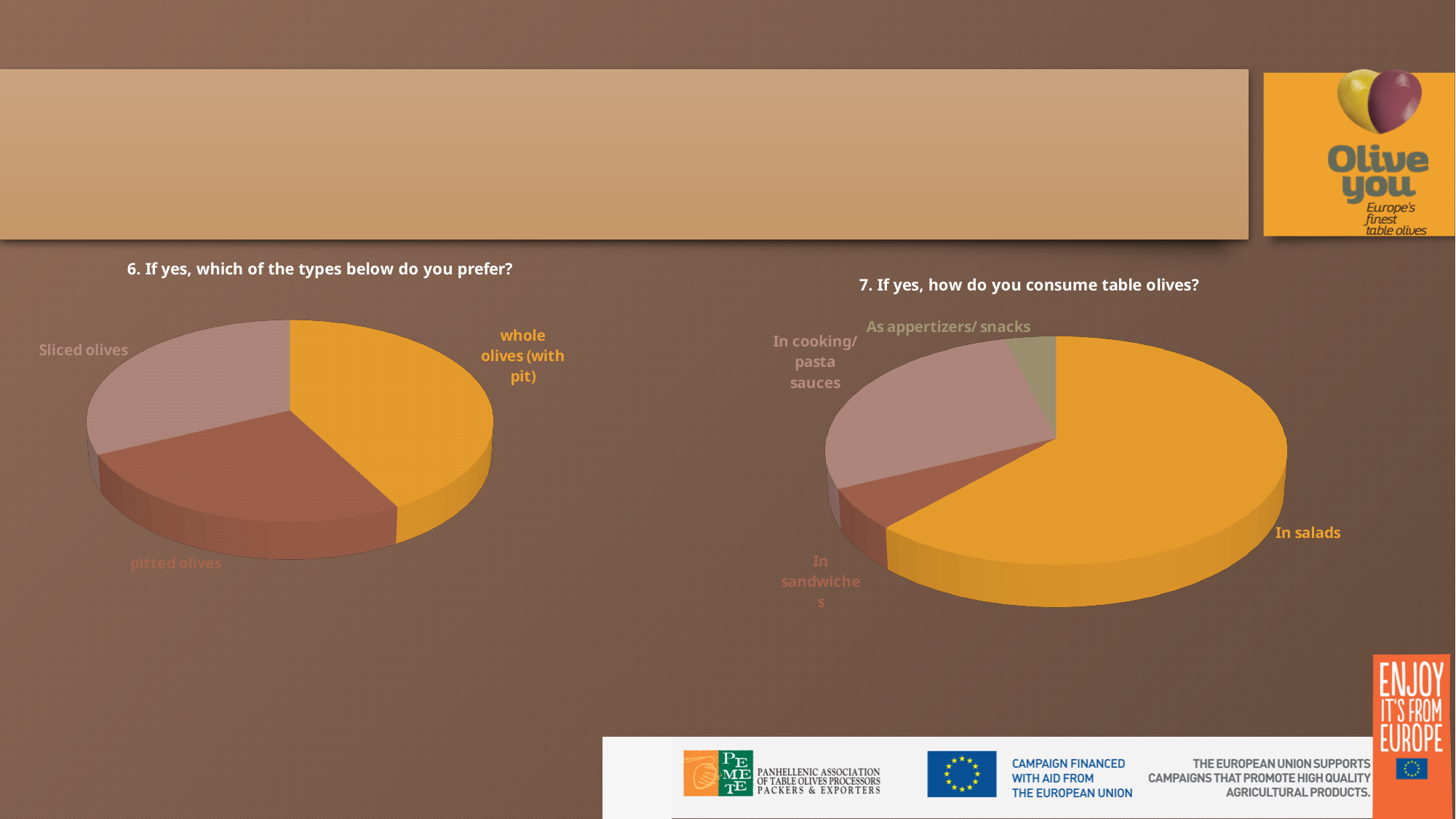
What kind of chart is used for "6. If yes, which of the types below do you prefer?"? Pie chart In the chart "7. If yes, how do you consume table olives?", which category has the largest slice? In salads In the chart "7. If yes, how do you consume table olives?", what colour is the In salads slice? Orange In the chart "6. If yes, which of the types below do you prefer?", which is larger: whole olives (with pit) or Sliced olives? whole olives (with pit) In the chart "6. If yes, which of the types below do you prefer?", how many categories are shown? 3 What kind of chart is used for "7. If yes, how do you consume table olives?"? Pie chart In the chart "7. If yes, how do you consume table olives?", which category has the smallest slice? As appertizers/ snacks In the chart "7. If yes, how do you consume table olives?", how many categories are shown? 4 What is the title of the pie chart on the left side of the slide? 6. If yes, which of the types below do you prefer? In the chart "7. If yes, how do you consume table olives?", which is larger: In salads or In sandwiches? In salads In the chart "6. If yes, which of the types below do you prefer?", which type has the largest slice? whole olives (with pit) In the chart "7. If yes, how do you consume table olives?", which is larger: In cooking/pasta sauces or In sandwiches? In cooking/pasta sauces